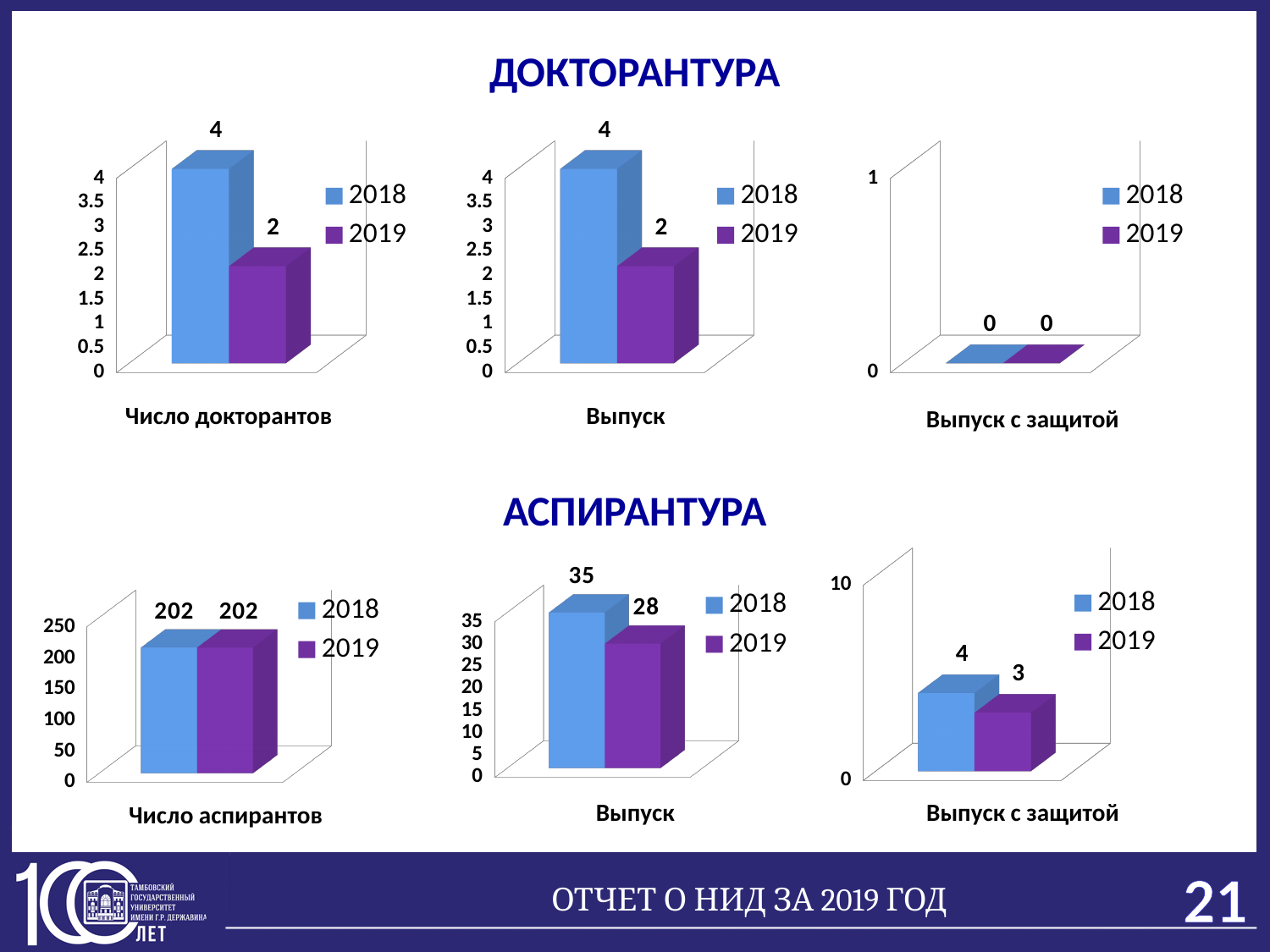
In the 'Выпуск' chart under АСПИРАНТУРА, which year has the higher value? 2018 In the 'Число аспирантов' chart under АСПИРАНТУРА, what is the total of the 2018 and 2019 values? 404 In the 'Выпуск' chart under АСПИРАНТУРА, what is the difference between the 2018 and 2019 values? 7 In the 'Выпуск с защитой' chart under ДОКТОРАНТУРА, what is the value for 2019? 0 How many series does the legend list in the 'Выпуск с защитой' chart under АСПИРАНТУРА? 2 In the 'Число аспирантов' chart under АСПИРАНТУРА, what is the value for 2018? 202 In the 'Число докторантов' chart under ДОКТОРАНТУРА, what is the value for 2019? 2 In the 'Число докторантов' chart under ДОКТОРАНТУРА, what is the value for 2018? 4 What kind of chart is the 'Число аспирантов' chart under АСПИРАНТУРА? bar chart In the 'Выпуск с защитой' chart under АСПИРАНТУРА, is the value for 2018 larger or smaller than the value for 2019? larger In the 'Выпуск' chart under ДОКТОРАНТУРА, what is the difference between the 2018 and 2019 values? 2 In the 'Выпуск' chart under АСПИРАНТУРА, what is the value for 2019? 28